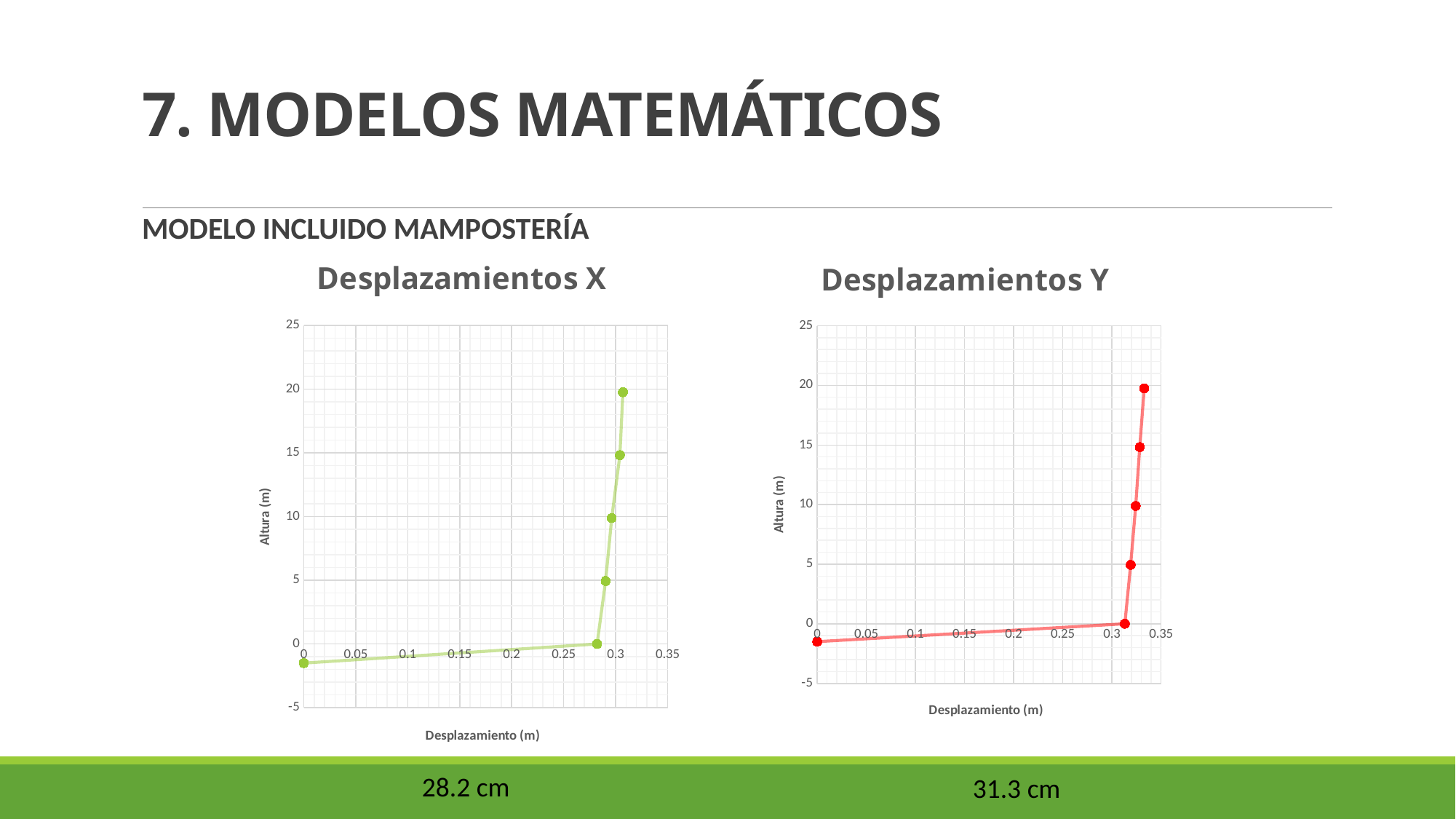
What kind of chart is the "Desplazamientos X" chart? line chart with markers Which chart has a larger displacement at its topmost point, "Desplazamientos X" or "Desplazamientos Y"? Desplazamientos Y How many data points are plotted on the "Desplazamientos X" chart? 6 On the "Desplazamientos Y" chart, is the displacement of the point at height 0 greater or less than 0.3? greater How many data points are plotted on the "Desplazamientos Y" chart? 6 On the "Desplazamientos X" chart, is the displacement of the lowest point greater or less than 0.05? less What is the label of the vertical axis on the "Desplazamientos Y" chart? Altura (m) On the "Desplazamientos Y" chart, is the height of the lowest point greater or less than 0? less What is the title of the left chart? Desplazamientos X On the "Desplazamientos X" chart, does the height rise or fall as the displacement increases? rises